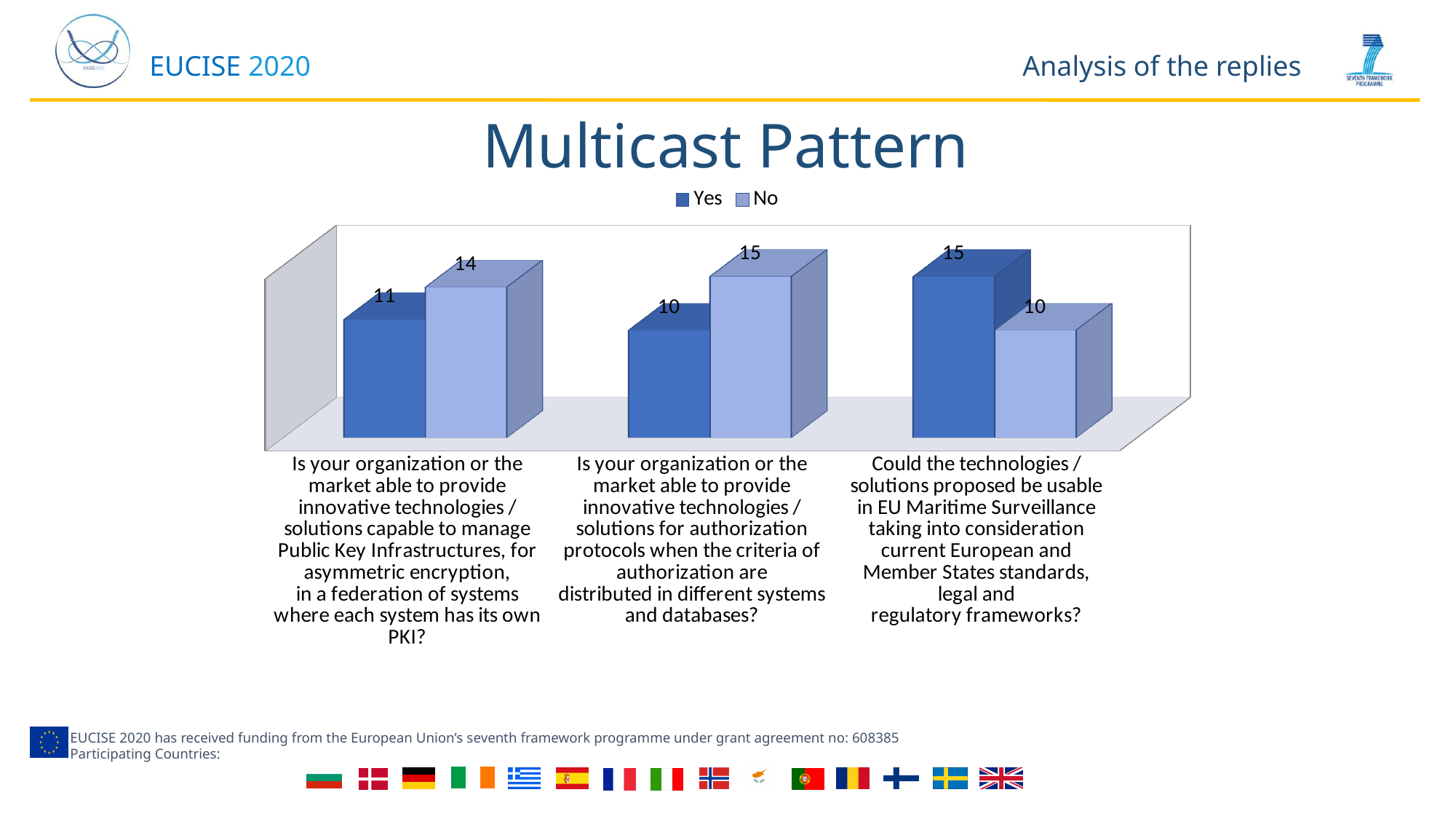
What is the difference between the 'No' and 'Yes' values for the question about authorization protocols? 5 What is the 'Yes' value for the question about managing Public Key Infrastructures? 11 What is the 'No' value for the question about usability in EU Maritime Surveillance? 10 Which question has the lowest 'No' value? Could the technologies / solutions proposed be usable in EU Maritime Surveillance taking into consideration current European and Member States standards, legal and regulatory frameworks? What is the 'Yes' value for the question about usability in EU Maritime Surveillance? 15 What kind of chart is shown on the slide? Bar chart Which question has the highest 'Yes' value? Could the technologies / solutions proposed be usable in EU Maritime Surveillance taking into consideration current European and Member States standards, legal and regulatory frameworks? How many series does the legend list? 2 What is the 'No' value for the question about authorization protocols with distributed criteria? 15 What is the 'Yes' value for the question about authorization protocols with distributed criteria? 10 What is the 'No' value for the question about managing Public Key Infrastructures? 14 For the question about managing Public Key Infrastructures, which is larger, 'Yes' or 'No'? No